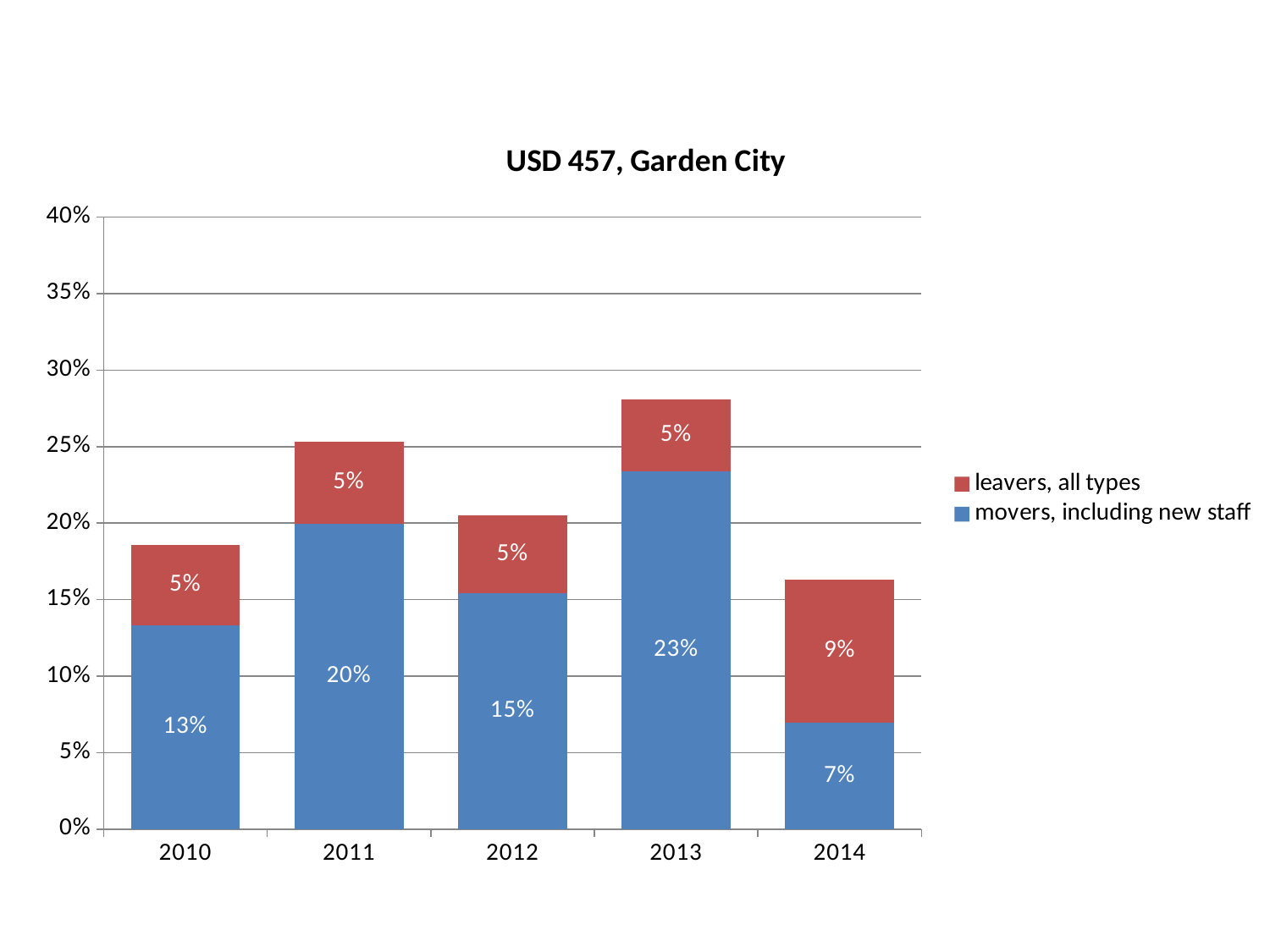
What is the difference between the movers, including new staff values for 2013 and 2014? 16% Which year has the highest value for leavers, all types? 2014 What is the value for leavers, all types in 2014? 9% Which year has the larger value for movers, including new staff: 2011 or 2012? 2011 Is the total height of the 2013 bar greater or less than 25%? greater How many years are shown on the x axis? 5 Which year has the lowest value for movers, including new staff? 2014 What kind of chart is shown on the slide? Stacked bar chart How many series does the legend list? 2 What is the value for movers, including new staff in 2011? 20% What is the value for movers, including new staff in 2013? 23% Which year has the highest value for movers, including new staff? 2013